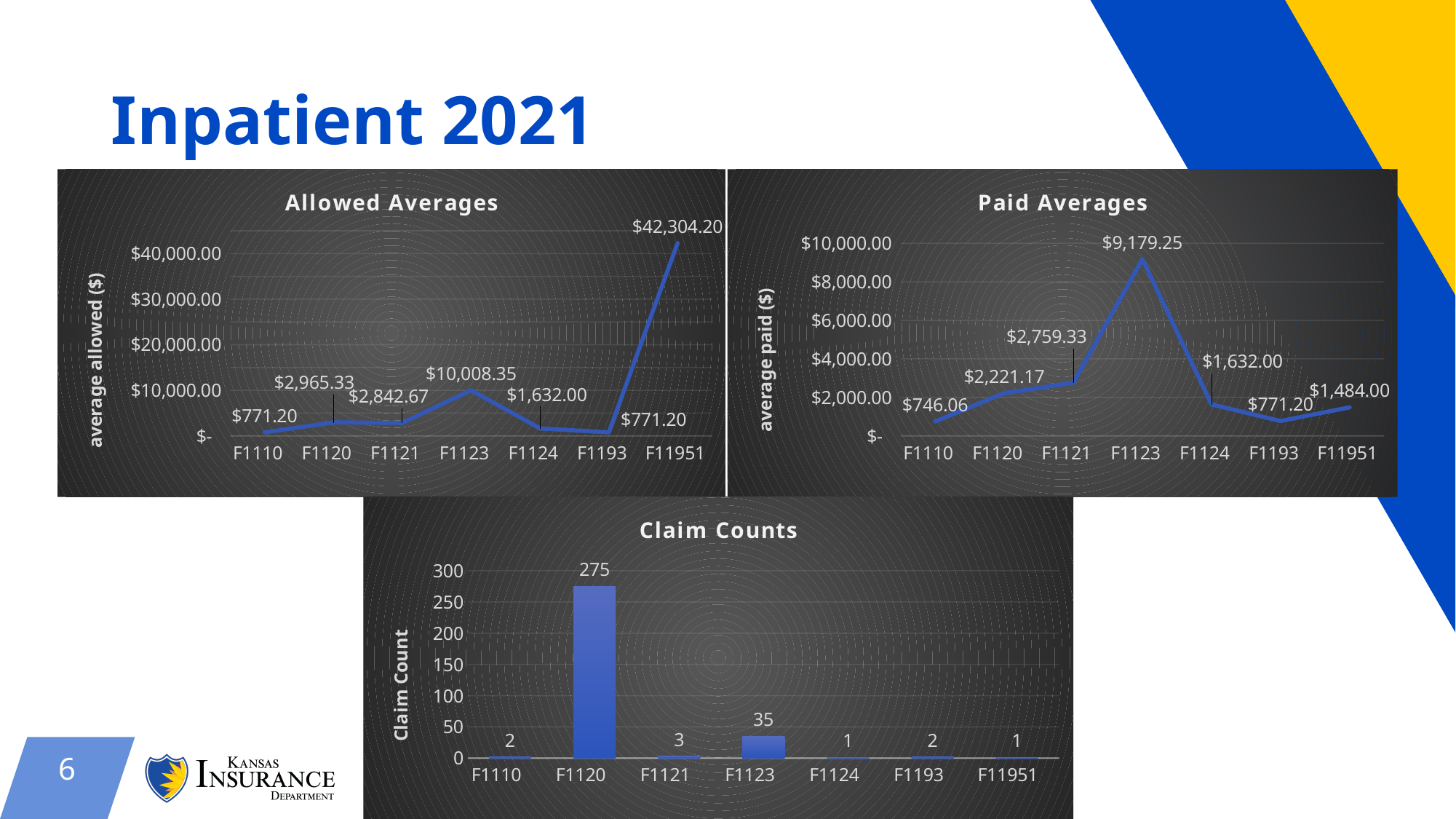
In the Paid Averages chart, which is larger, the value for F1120 or the value for F1121? F1121 In the Allowed Averages chart, which category has the highest value? F11951 In the Claim Counts chart, what is the claim count for F1120? 275 In the Paid Averages chart, what is the value for F1123? $9,179.25 What kind of chart is the Claim Counts chart? bar chart In the Allowed Averages chart, what is the value for F11951? $42,304.20 In the Allowed Averages chart, what is the difference between the values for F1120 and F1121? $122.66 In the Allowed Averages chart, what is the value for F1123? $10,008.35 How many categories are shown on the x axis of the Claim Counts chart? 7 In the Paid Averages chart, which category has the lowest value? F1110 In the Paid Averages chart, what is the difference between the values for F1123 and F11951? $7,695.25 In the Claim Counts chart, what is the difference between the claim counts for F1120 and F1123? 240